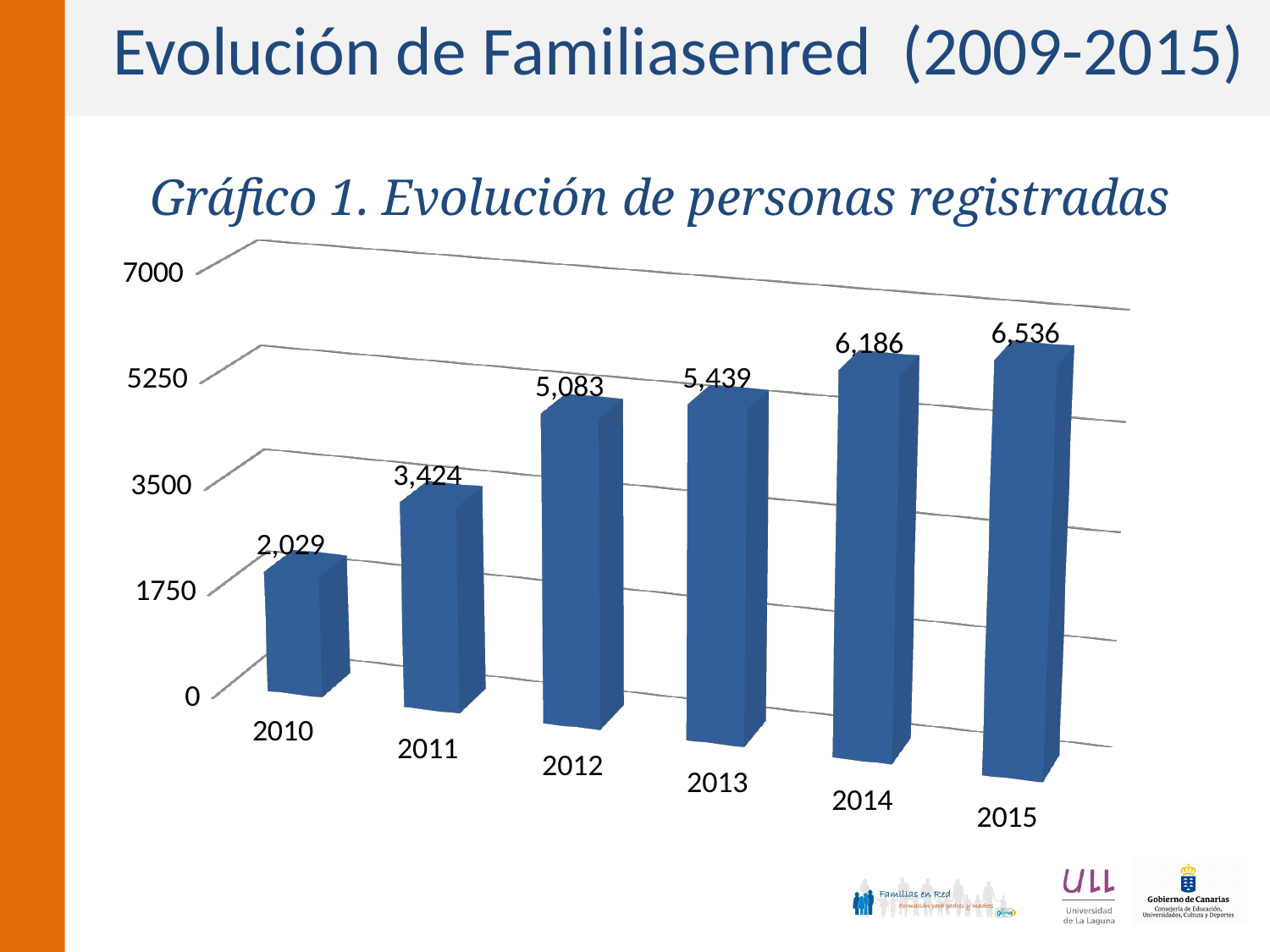
What is the value for 2015? 6,536 What kind of chart is shown? bar chart Which year has the lowest value? 2010 Which is larger, the value for 2012 or the value for 2013? 2013 What is the value for 2010? 2,029 What is the difference between the values for 2015 and 2014? 350 What is the value for 2013? 5,439 Which year has the highest value? 2015 Is the value for 2014 greater or less than 5250? greater Do the values rise or fall from 2010 to 2015? rise What is the difference between the values for 2011 and 2010? 1,395 How many years are shown on the chart? 6